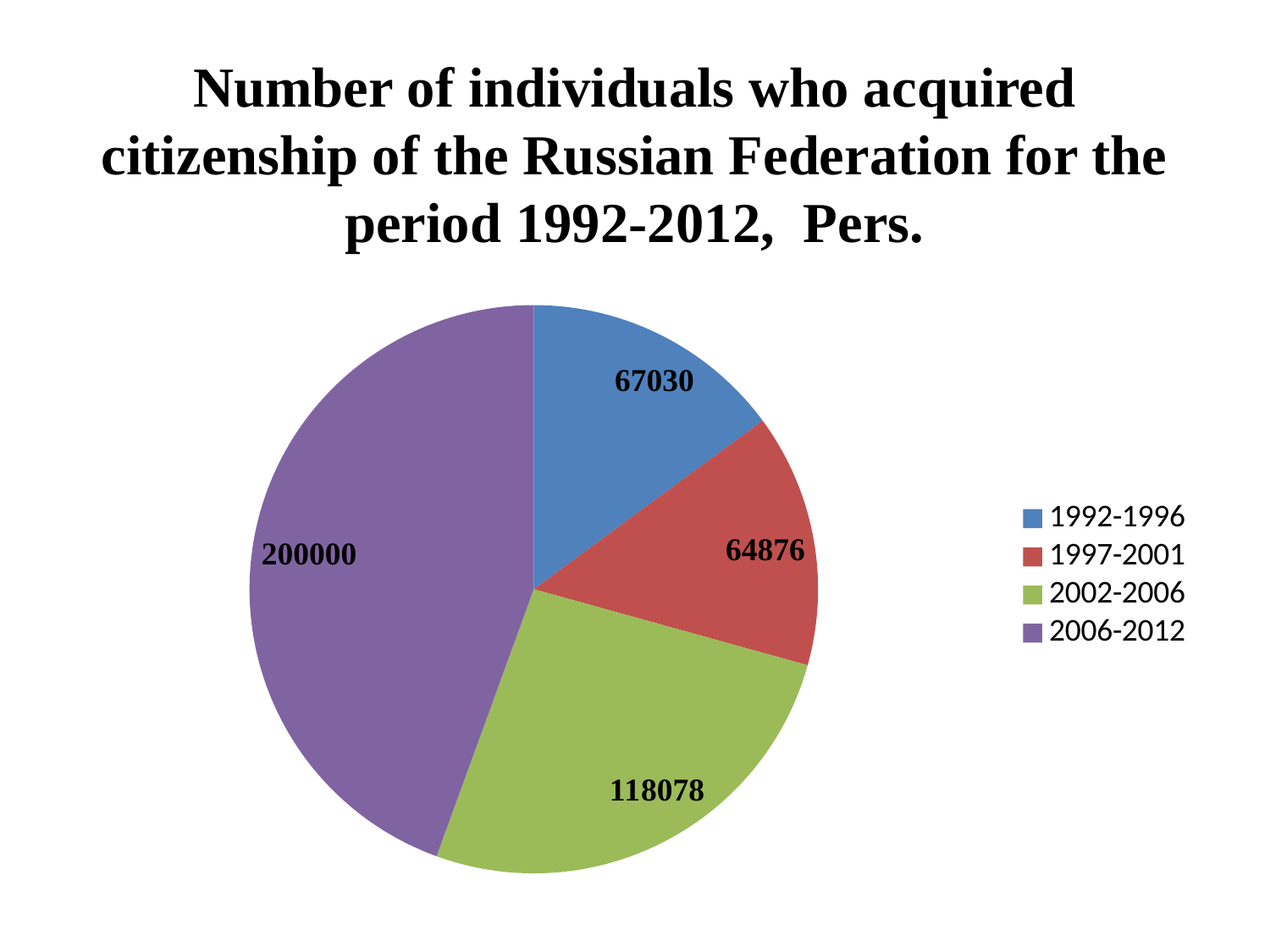
How many slices does the pie chart have? 4 Which period has the smallest number of individuals who acquired citizenship? 1997-2001 What is the value for the 2002-2006 slice? 118078 What is the value for the 1992-1996 slice? 67030 What kind of chart is shown on the slide? Pie chart Which is larger, the value for 1992-1996 or the value for 1997-2001? 1992-1996 Which colour represents the 2002-2006 period in the legend? Green What is the difference between the values for 1992-1996 and 1997-2001? 2154 What is the value for the 2006-2012 slice? 200000 Which period has the largest number of individuals who acquired citizenship? 2006-2012 What is the difference between the values for 2006-2012 and 2002-2006? 81922 What share of the total does the 2006-2012 slice represent, to the nearest whole percent? 44%